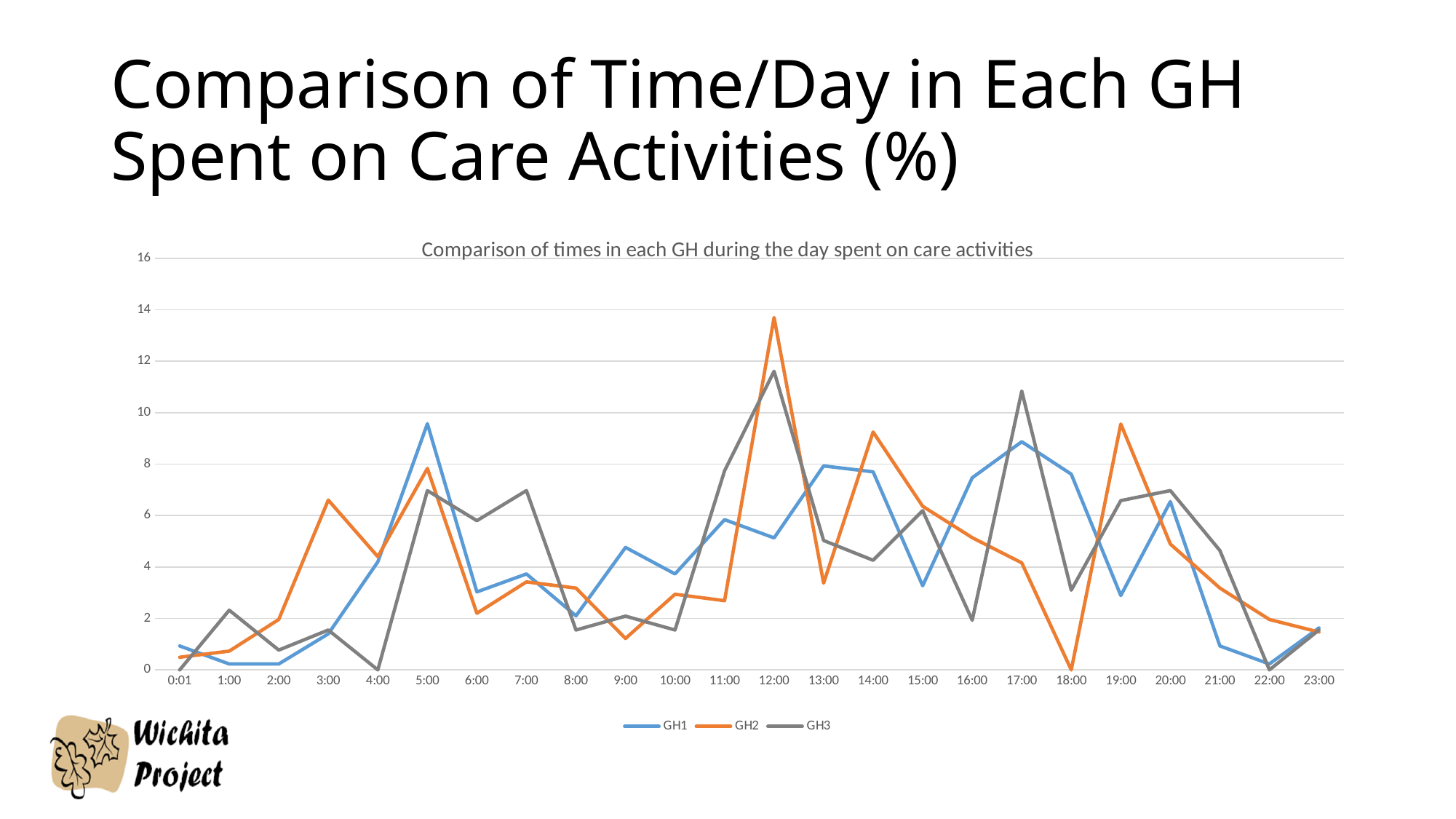
Is the value for GH1 at 5:00 greater or less than 8? greater How many series does the legend list? 3 How many time points are plotted along the x axis? 24 At which time does GH2 reach its highest value? 12:00 At 17:00, which series has the larger value, GH1 or GH2? GH1 What kind of chart is shown on the slide? Line chart Is the value for GH2 at 12:00 greater or less than 12? greater Does the GH1 line rise or fall from 17:00 to 22:00? Fall Is the value for GH3 at 17:00 greater or less than 10? greater At which time does GH2 reach its lowest value? 18:00 At 19:00, which series has the larger value, GH1 or GH2? GH2